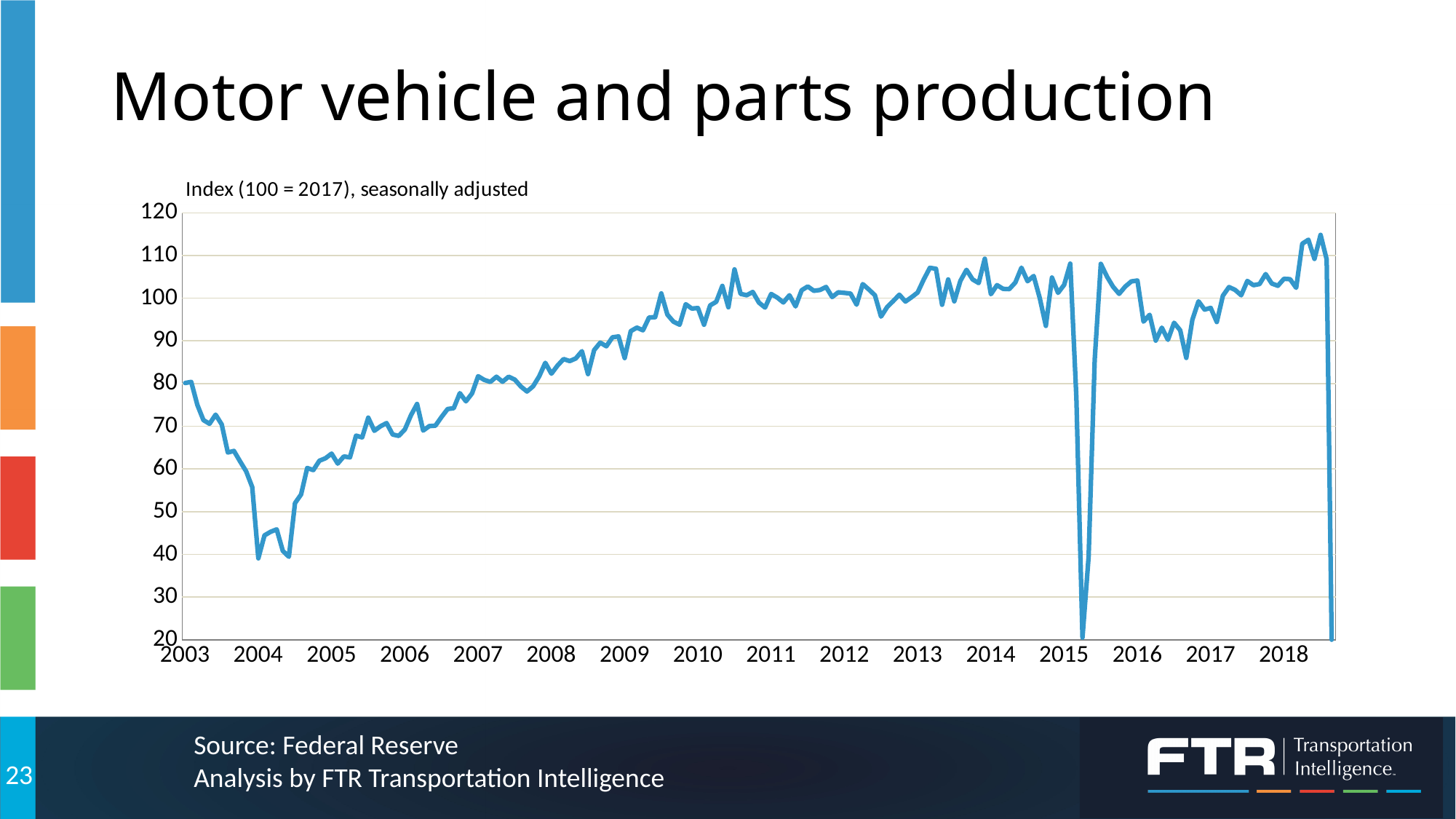
How many lines are plotted on the chart? 1 How many year labels are shown on the x axis? 16 Does the index rise or fall between 2003 and 2004? fall What kind of chart is shown on the slide? line chart Does the index rise or fall between 2004 and 2009? rise What does the note above the chart say the index is based on? Index (100 = 2017), seasonally adjusted Which is larger, the value at the start of 2005 or the value at the start of 2010? 2010 What is the title of the chart on the slide? Motor vehicle and parts production Is the value at the start of 2005 greater or less than 70? less Is the value at the start of 2010 greater or less than 90? greater In which year does the line reach its highest value? 2018 Is the value at the start of 2016 greater or less than 90? greater